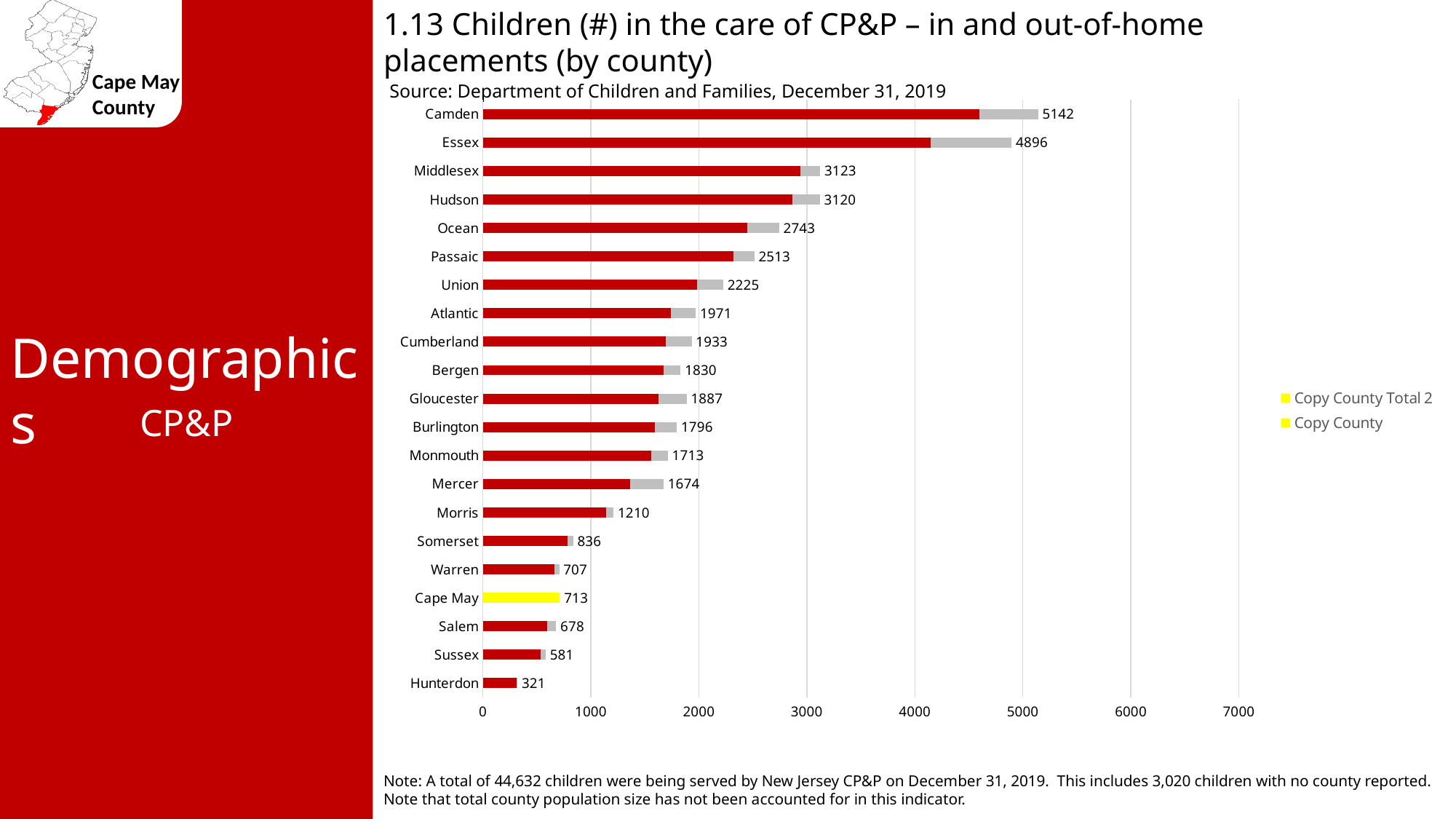
What kind of chart is shown on the slide? Bar chart Which county has the lowest value in the chart? Hunterdon What is the difference between the values for Camden and Essex? 246 Is the value for Ocean greater or less than 3000? less What is the total number of children in the care of CP&P shown for Camden? 5142 What value is shown for Cape May? 713 Which has a larger value, Bergen or Gloucester? Gloucester How many counties are shown in the chart? 21 Which county has the highest value in the chart? Camden What is the difference between the values for Cape May and Warren? 6 What value is shown for Morris? 1210 How many series does the legend list? 2